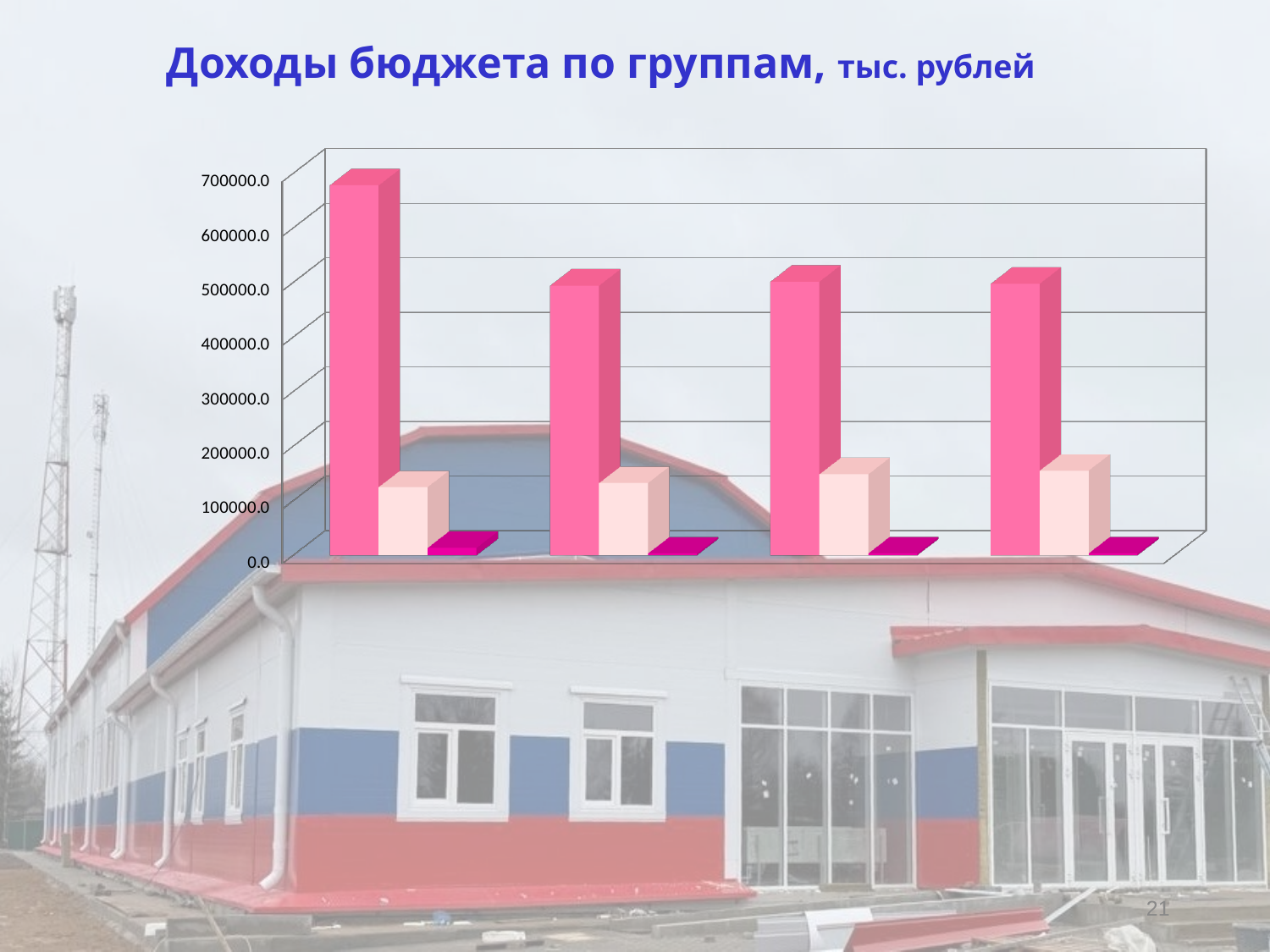
Which is larger: the tallest bar in the leftmost group or the tallest bar in the rightmost group? the leftmost group How many bars are there in each group? 3 Which group of bars contains the tallest bar in the chart? the leftmost (first) group Is the light pink bar in the rightmost group greater or less than 100000.0? greater What kind of chart is shown on the slide? bar chart Is the tallest bar in the leftmost group greater or less than 600000.0? greater Which colour of bar is the lowest in every group? magenta Is the light pink bar in the leftmost group greater or less than 200000.0? less What is the title of the chart? Доходы бюджета по группам, тыс. рублей How many groups of bars are plotted in the chart? 4